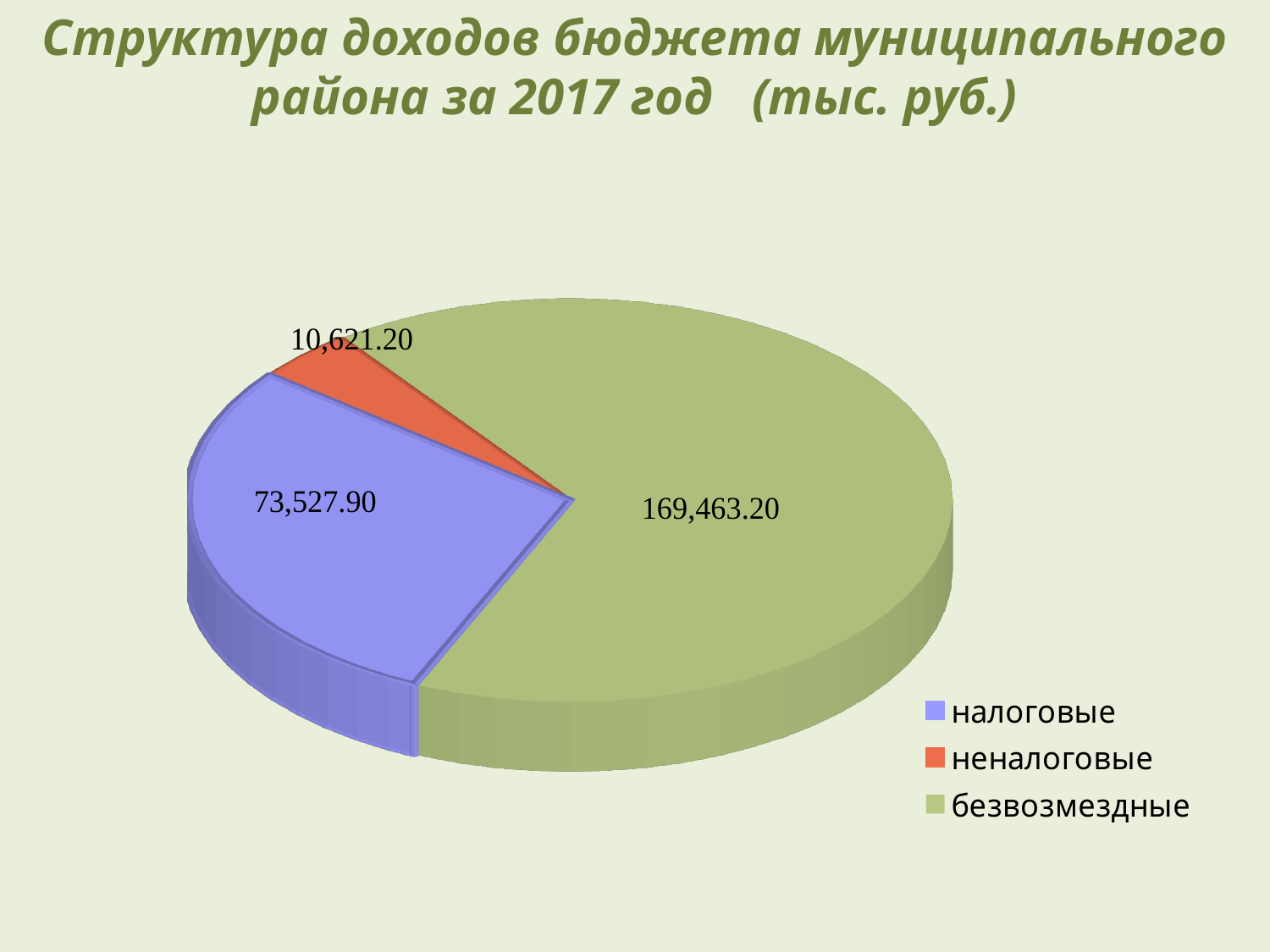
Which is larger, налоговые or неналоговые? налоговые What is the value for неналоговые? 10,621.20 What is the value for безвозмездные? 169,463.20 Which category has the largest value? безвозмездные What is the difference between the values for безвозмездные and налоговые? 95,935.30 How many slices does the pie chart have? 3 Which category has the smallest value? неналоговые What is the total of all slices in the pie chart? 253,612.30 What is the value for налоговые? 73,527.90 What is the difference between the values for налоговые and неналоговые? 62,906.70 What colour is the slice for неналоговые? Red What type of chart is shown on the slide? Pie chart